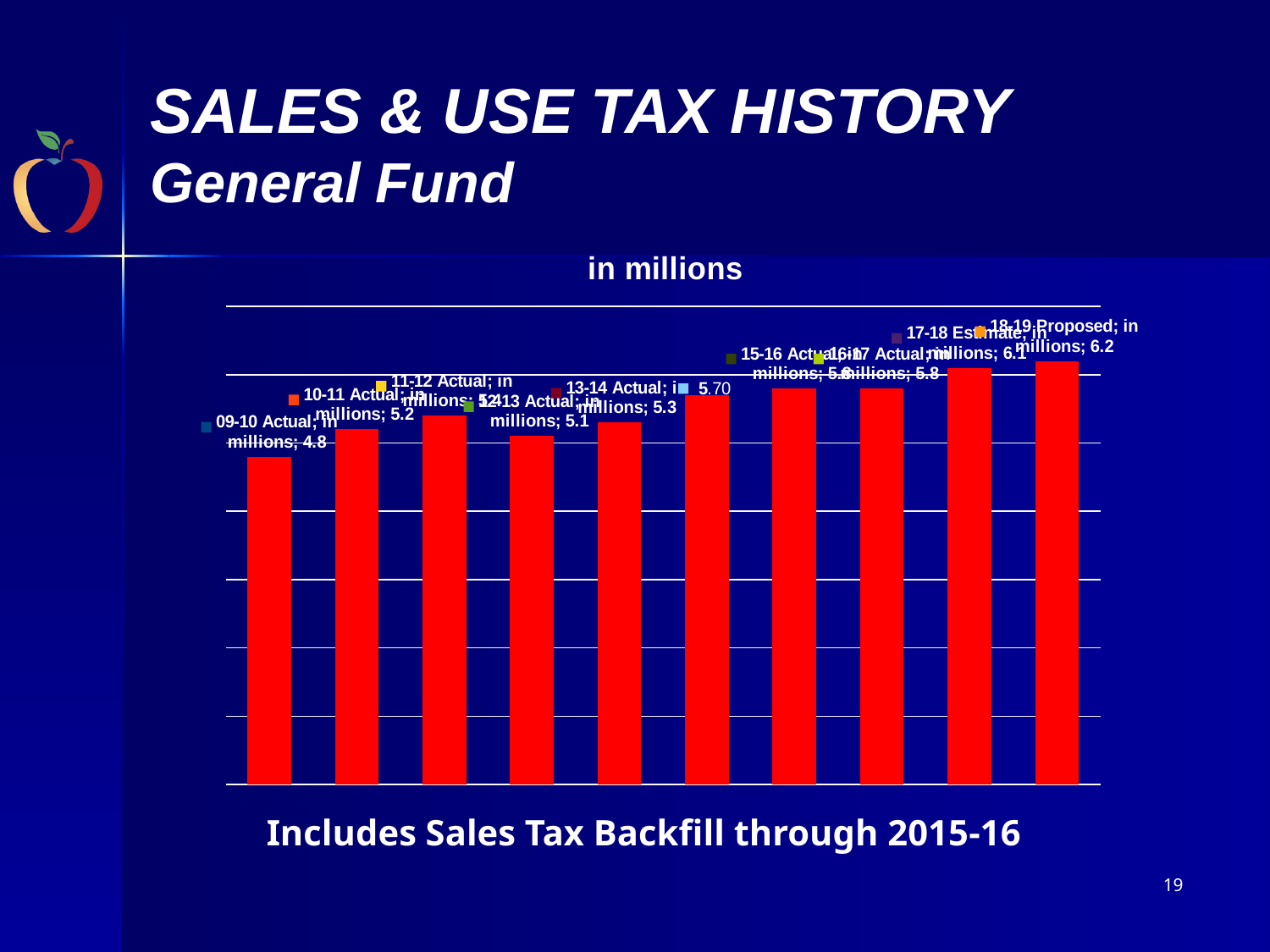
What is the value for 17-18 Estimate? 6.1 What is the value for 09-10 Actual? 4.8 What is the value for 15-16 Actual? 5.8 Which is larger, the value for 13-14 Actual or the value for 12-13 Actual? 13-14 Actual Which year has the highest value in the chart? 18-19 Proposed What kind of chart is shown on the slide? bar chart Do the values generally rise or fall from 09-10 to 18-19? rise What colour are the bars in the chart? red What is the value for 18-19 Proposed? 6.2 How many bars are plotted in the chart? 10 Which year has the lowest value in the chart? 09-10 Actual What is the difference between the 18-19 Proposed value and the 09-10 Actual value? 1.4